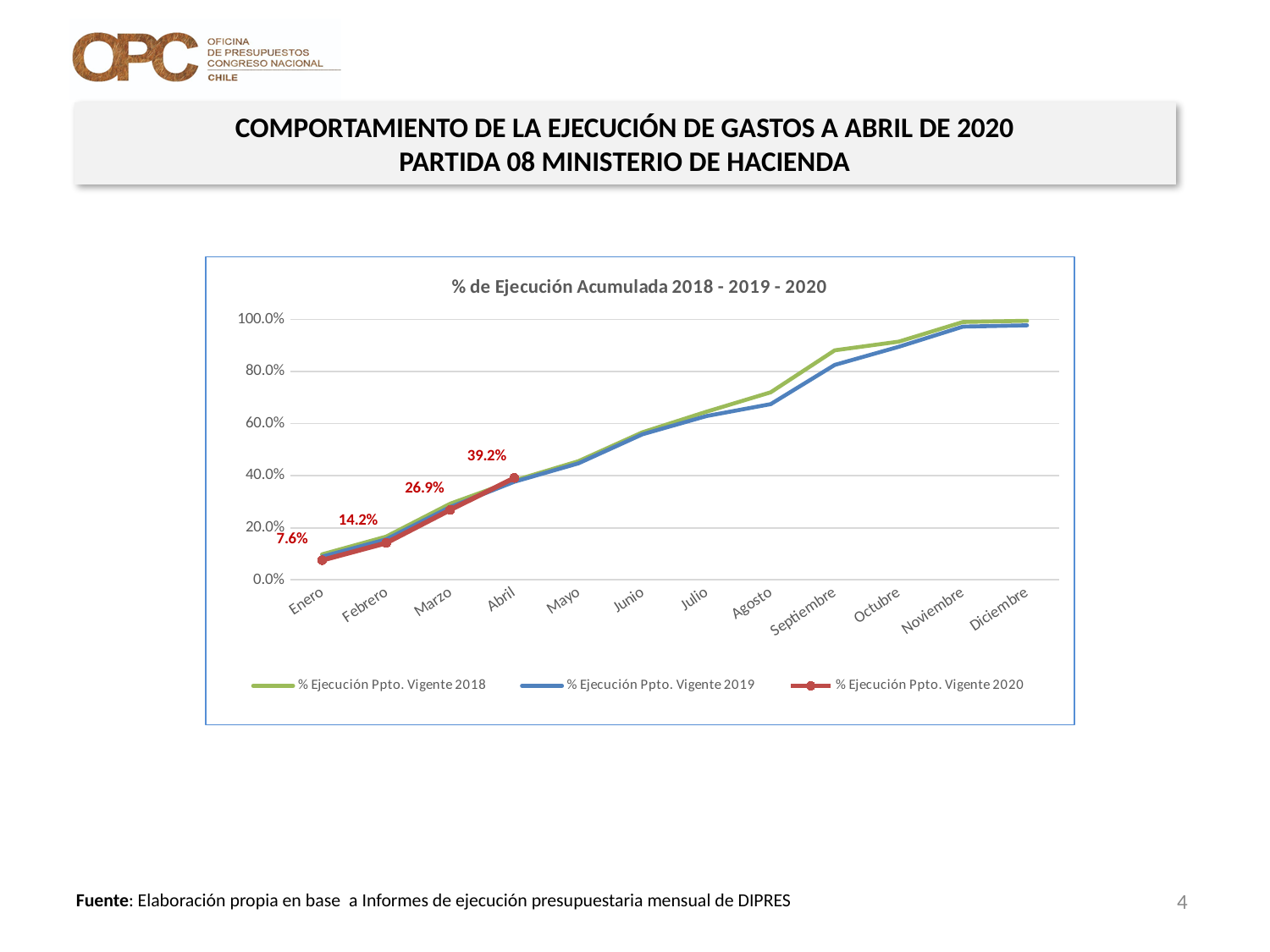
What is the value for % Ejecución Ppto. Vigente 2020 in Febrero? 14.2% What is the value for % Ejecución Ppto. Vigente 2020 in Abril? 39.2% Is the value for % Ejecución Ppto. Vigente 2018 in Septiembre greater or less than 80.0%? greater What is the title of the chart? % de Ejecución Acumulada 2018 - 2019 - 2020 What kind of chart is shown on the slide? line chart Which month has the highest value for the % Ejecución Ppto. Vigente 2020 series? Abril How many series does the legend list? 3 What is the value for % Ejecución Ppto. Vigente 2020 in Marzo? 26.9% What is the difference between the 2020 values for Abril and Marzo? 12.3% Do the values of the % Ejecución Ppto. Vigente 2019 series rise or fall from Enero to Diciembre? rise What is the value for % Ejecución Ppto. Vigente 2020 in Enero? 7.6% How many months are shown on the x axis? 12